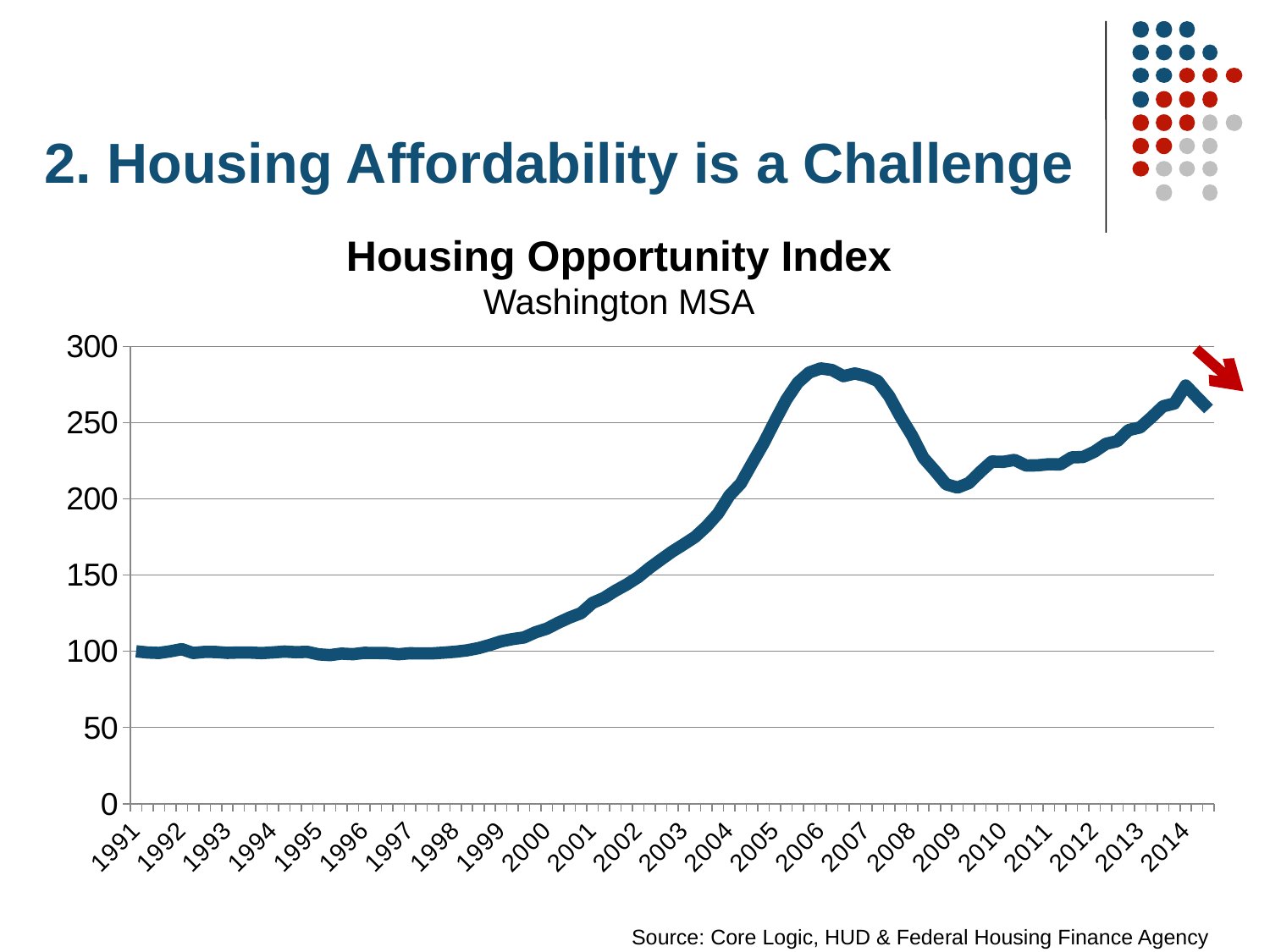
Which year has the higher Housing Opportunity Index, 2006 or 2009? 2006 Is the value for 2006 greater or less than 250? greater In which year does the Housing Opportunity Index reach its highest point? 2006 How many year labels are shown on the x axis? 24 Is the value for 2012 greater or less than 200? greater Is the value for 2001 greater or less than 150? less Does the Housing Opportunity Index rise or fall between 1998 and 2006? rise What is the title of the chart? Housing Opportunity Index Which metropolitan area does the chart cover, according to its subtitle? Washington MSA What kind of chart is shown on the slide? line chart